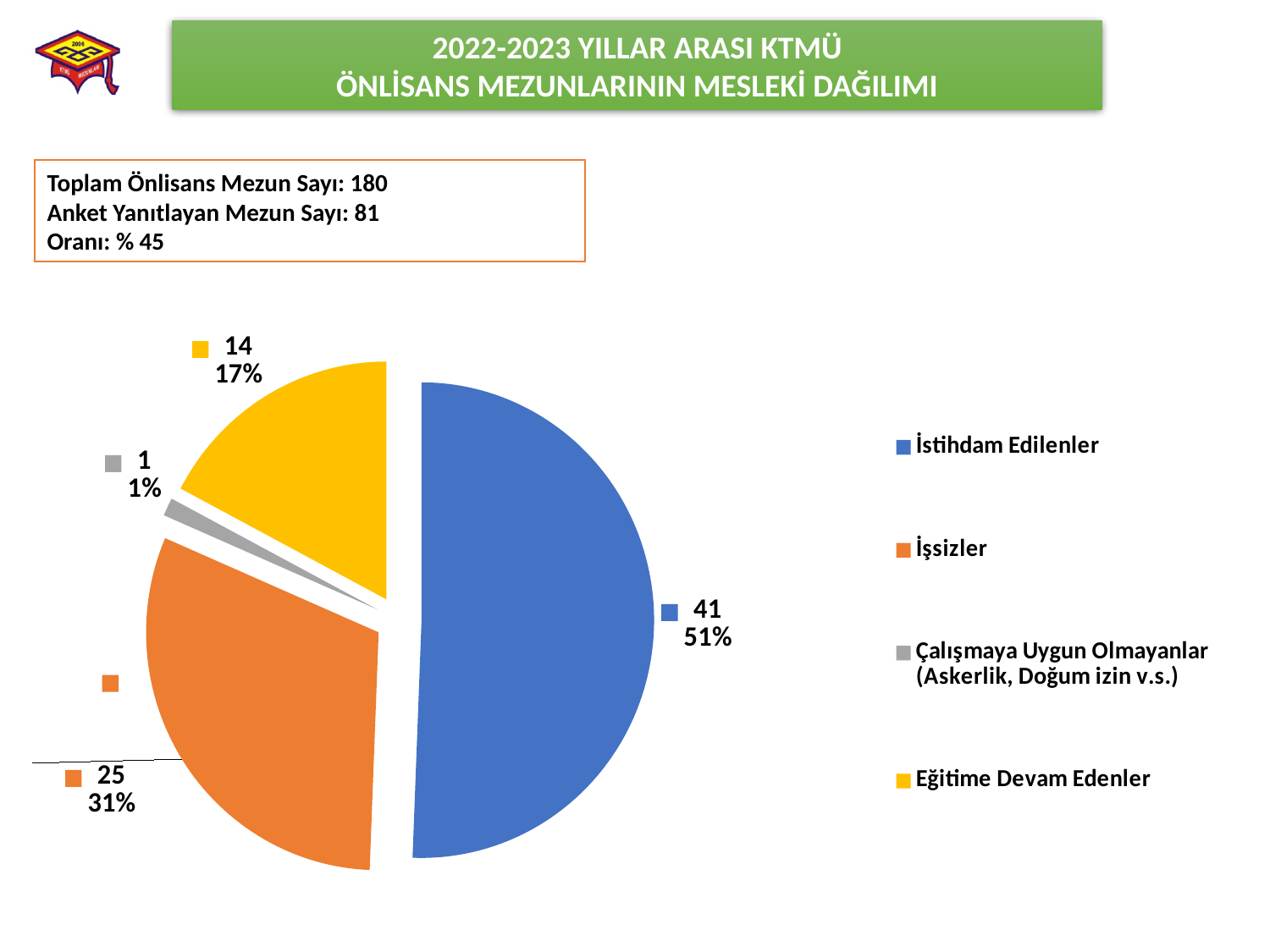
What share of the pie does İstihdam Edilenler represent? 51% Which category has the largest slice in the pie chart? İstihdam Edilenler What share of the pie does Eğitime Devam Edenler represent? 17% What is the difference between the values for İstihdam Edilenler and İşsizler? 16 How many entries does the legend of the pie chart list? 4 How many slices does the pie chart have? 4 Which category has the smallest slice in the pie chart? Çalışmaya Uygun Olmayanlar (Askerlik, Doğum izin v.s.) What is the value for İstihdam Edilenler in the pie chart? 41 What is the value for Eğitime Devam Edenler in the pie chart? 14 What type of chart is shown on the slide? pie chart What is the value for Çalışmaya Uygun Olmayanlar (Askerlik, Doğum izin v.s.) in the pie chart? 1 What is the value for İşsizler in the pie chart? 25